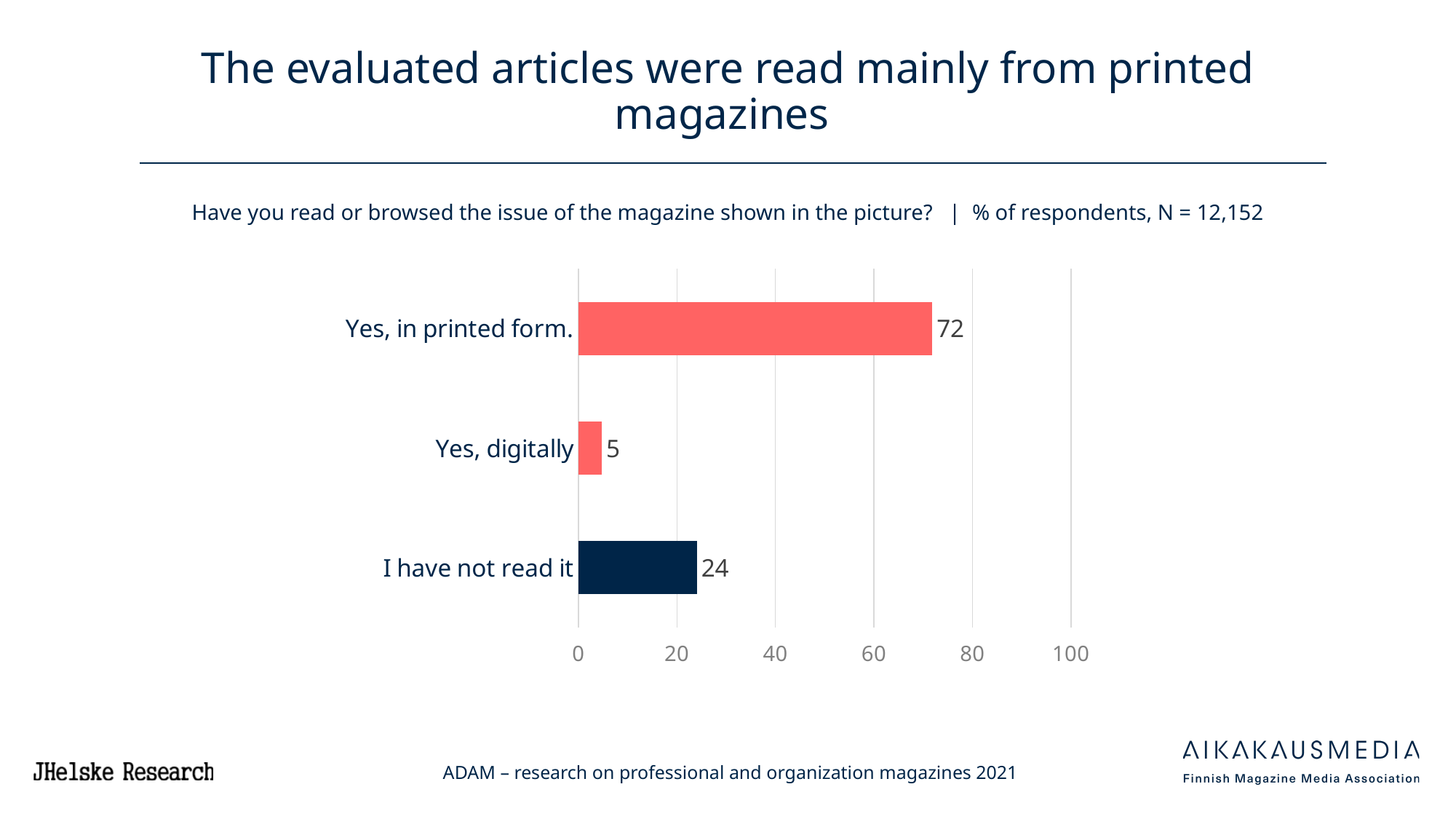
Which is larger, the value for "I have not read it" or the value for "Yes, digitally"? I have not read it How many categories are shown in the chart? 3 What kind of chart is shown on the slide? bar chart Is the value for "Yes, in printed form." greater or less than 60? greater What is the value for "Yes, digitally"? 5 What is the value for "I have not read it"? 24 What is the value for "Yes, in printed form."? 72 What is the difference between the values for "Yes, in printed form." and "I have not read it"? 48 What is the difference between the values for "I have not read it" and "Yes, digitally"? 19 Which category has the highest value? Yes, in printed form. Which category has the lowest value? Yes, digitally What is the sample size (N) stated in the chart subtitle? 12,152